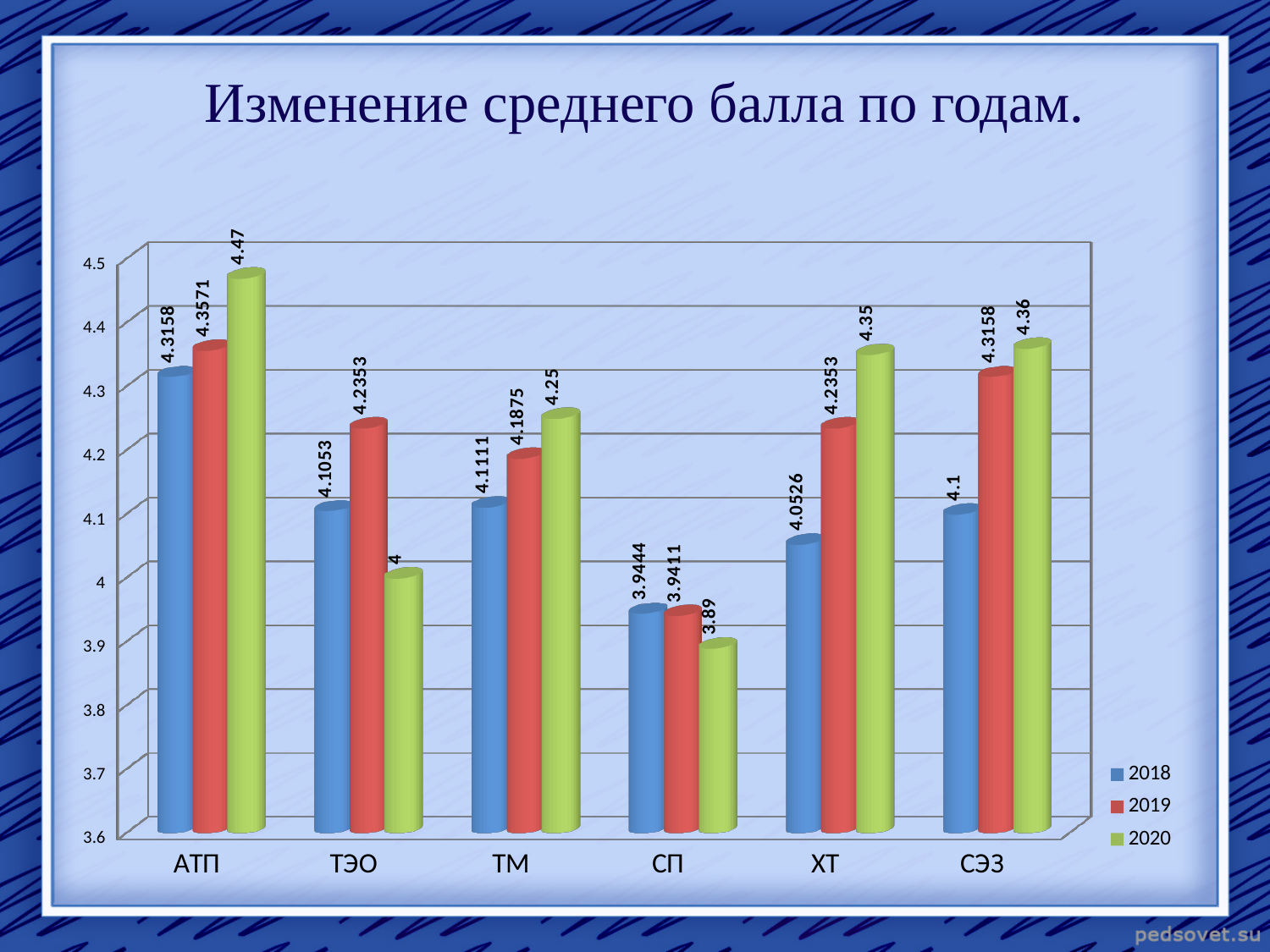
What is the difference between the 2020 and 2018 values for ХТ? 0.2974 What is the value for СЭЗ in 2018? 4.1 Which category has the lowest value in 2019? СП What is the value for АТП in 2020? 4.47 What is the value for СП in 2018? 3.9444 How many categories are shown on the x axis? 6 Which colour represents the 2019 series in the legend? Red Which is larger for ТМ: the 2019 value or the 2020 value? 2020 What is the value for ТЭО in 2019? 4.2353 What kind of chart is shown on the slide? Bar chart How many series does the legend list? 3 Which category has the highest value in 2020? АТП